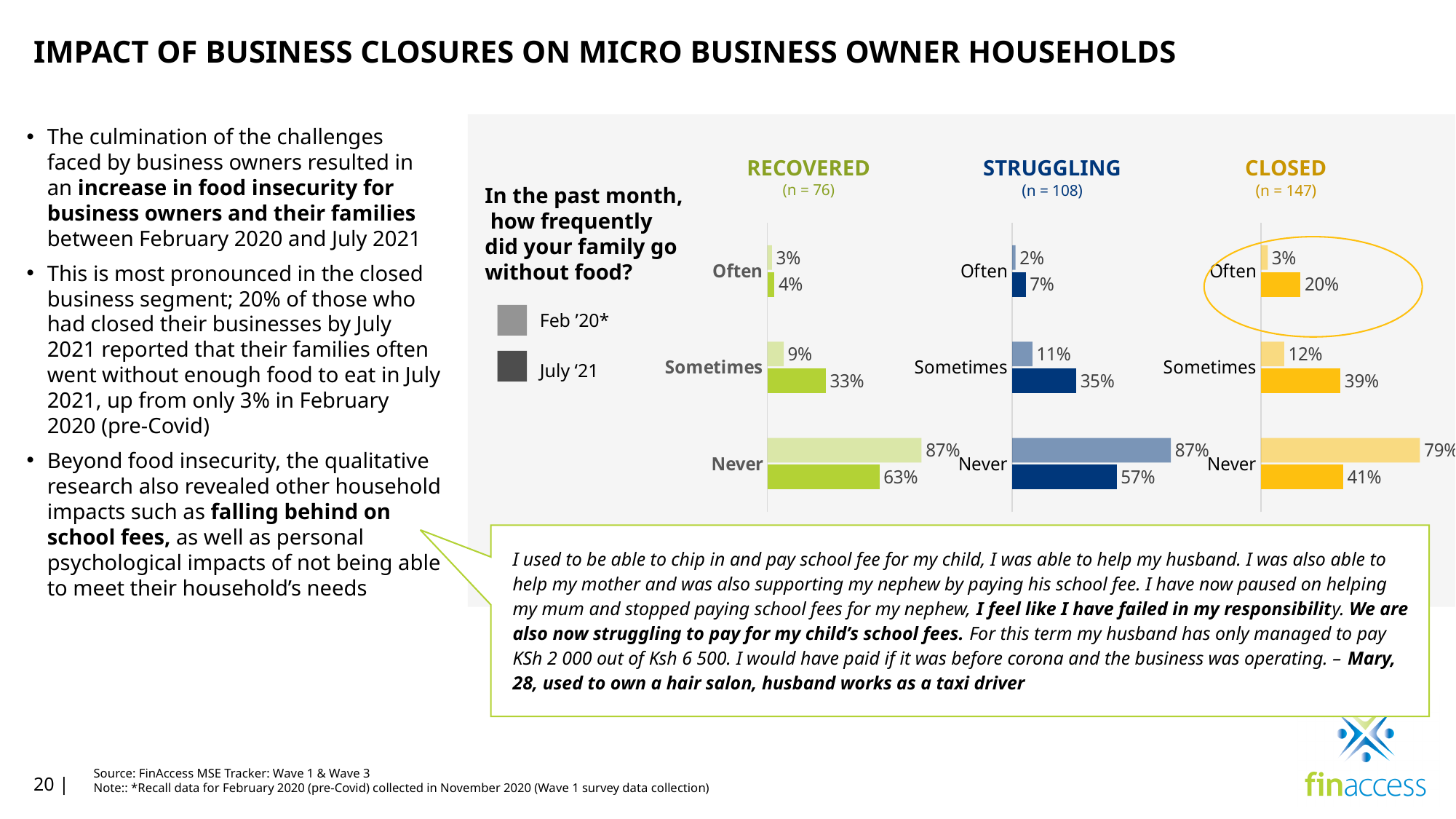
In the CLOSED chart, what is the difference between the Feb '20 and July '21 values for Never? 38% How many series does the legend list? 2 What type of chart is used for the RECOVERED, STRUGGLING and CLOSED data? Bar chart In the STRUGGLING chart, which category has the lowest Feb '20 value? Often What is the sample size (n) shown for the CLOSED chart? 147 In the RECOVERED chart, which category has the highest July '21 value? Never In the STRUGGLING chart, what is the July '21 value for Sometimes? 35% In the STRUGGLING chart, is the July '21 value for Never larger or smaller than the July '21 value for Never in the CLOSED chart? larger In the CLOSED chart, what percentage of families often went without food in July '21? 20% How many categories does each chart show? 3 In the CLOSED chart, what is the Feb '20 value for Sometimes? 12% In the RECOVERED chart, what is the Feb '20 value for Never? 87%